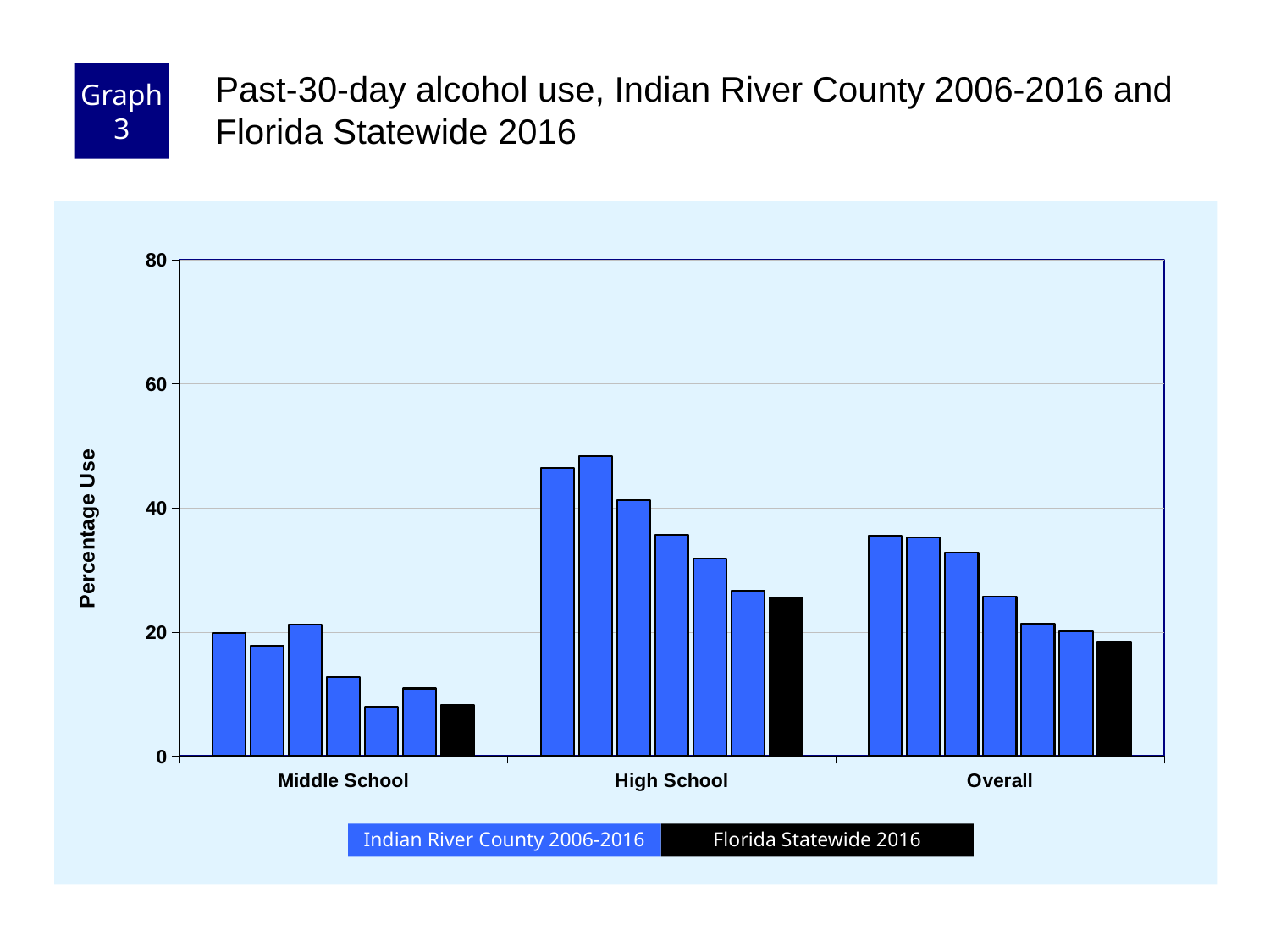
What kind of chart is shown on the slide? bar chart Within the Overall group, do the Indian River County bars rise or fall from left to right? fall Which category has the highest bars? High School How many categories are shown on the x axis? 3 Is the tallest Indian River County bar in the High School group greater or less than 40? greater Which is larger: the Florida Statewide 2016 bar for High School or the Florida Statewide 2016 bar for Middle School? High School Is the Florida Statewide 2016 value for Middle School greater or less than 20? less What is the label on the y axis? Percentage Use What colour are the Florida Statewide 2016 bars? black Is the Florida Statewide 2016 value for High School greater or less than 20? greater Which category has the lowest bars? Middle School How many series does the legend list? 2